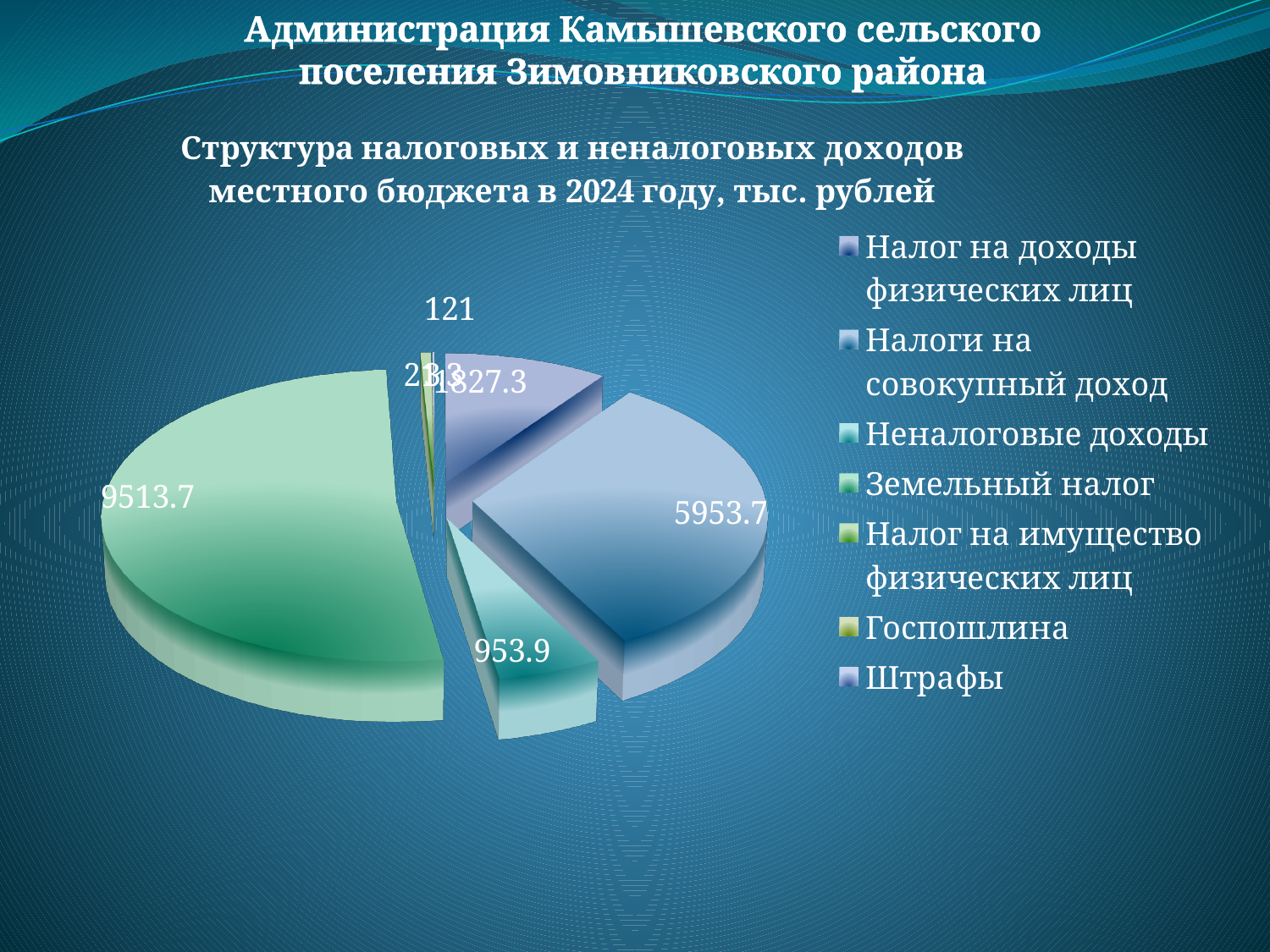
Which category has the largest slice of the pie? Земельный налог What is the difference between Налог на доходы физических лиц and Неналоговые доходы? 873.4 How many categories does the legend list? 7 What type of chart is shown on the slide? Pie chart What is the value for Земельный налог? 9513.7 What is the value for Неналоговые доходы? 953.9 What year does the chart title refer to? 2024 What is the value for Налог на доходы физических лиц? 1827.3 What is the value for Налоги на совокупный доход? 5953.7 In what units are the values given according to the chart title? тыс. рублей Which is larger: Налоги на совокупный доход or Неналоговые доходы? Налоги на совокупный доход What is the difference between Земельный налог and Налоги на совокупный доход? 3560